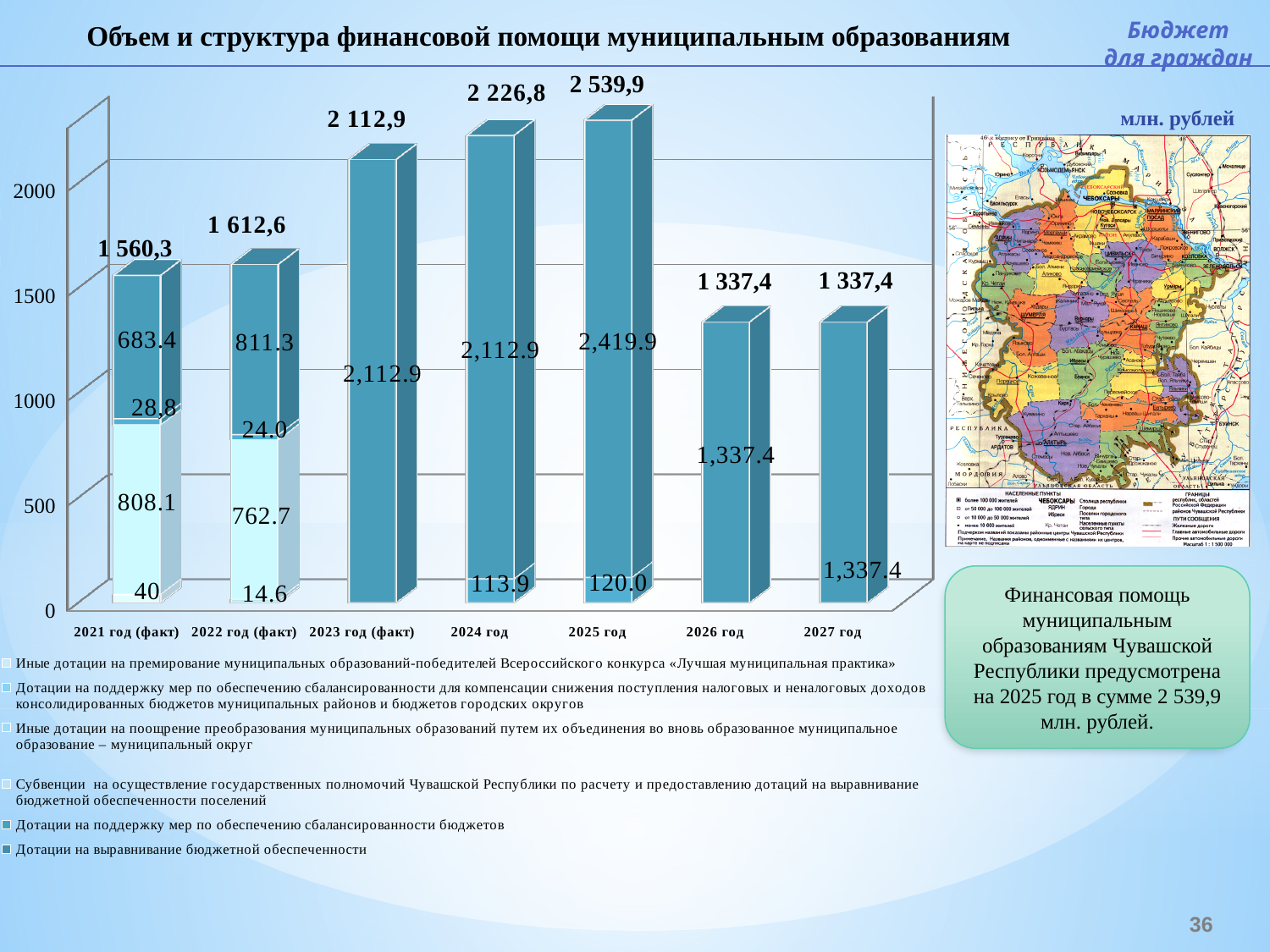
Do the totals rise or fall from 2021 год (факт) to 2025 год? rise Which year has the highest total financial aid in the chart? 2025 год Which total is larger, 2021 год (факт) or 2022 год (факт)? 2022 год (факт) What is the difference between the totals for 2025 год and 2024 год? 313,1 What is the total financial aid shown above the bar for 2025 год? 2 539,9 What is the total value labelled above the bar for 2021 год (факт)? 1 560,3 How many years (categories) are shown on the x axis of the chart? 7 How many series does the legend list? 6 What is the difference between the totals for 2023 год (факт) and 2022 год (факт)? 500,3 What is the total value labelled above the bar for 2023 год (факт)? 2 112,9 What kind of chart is shown on the slide? bar chart Is the total for 2026 год greater or less than 1500? less